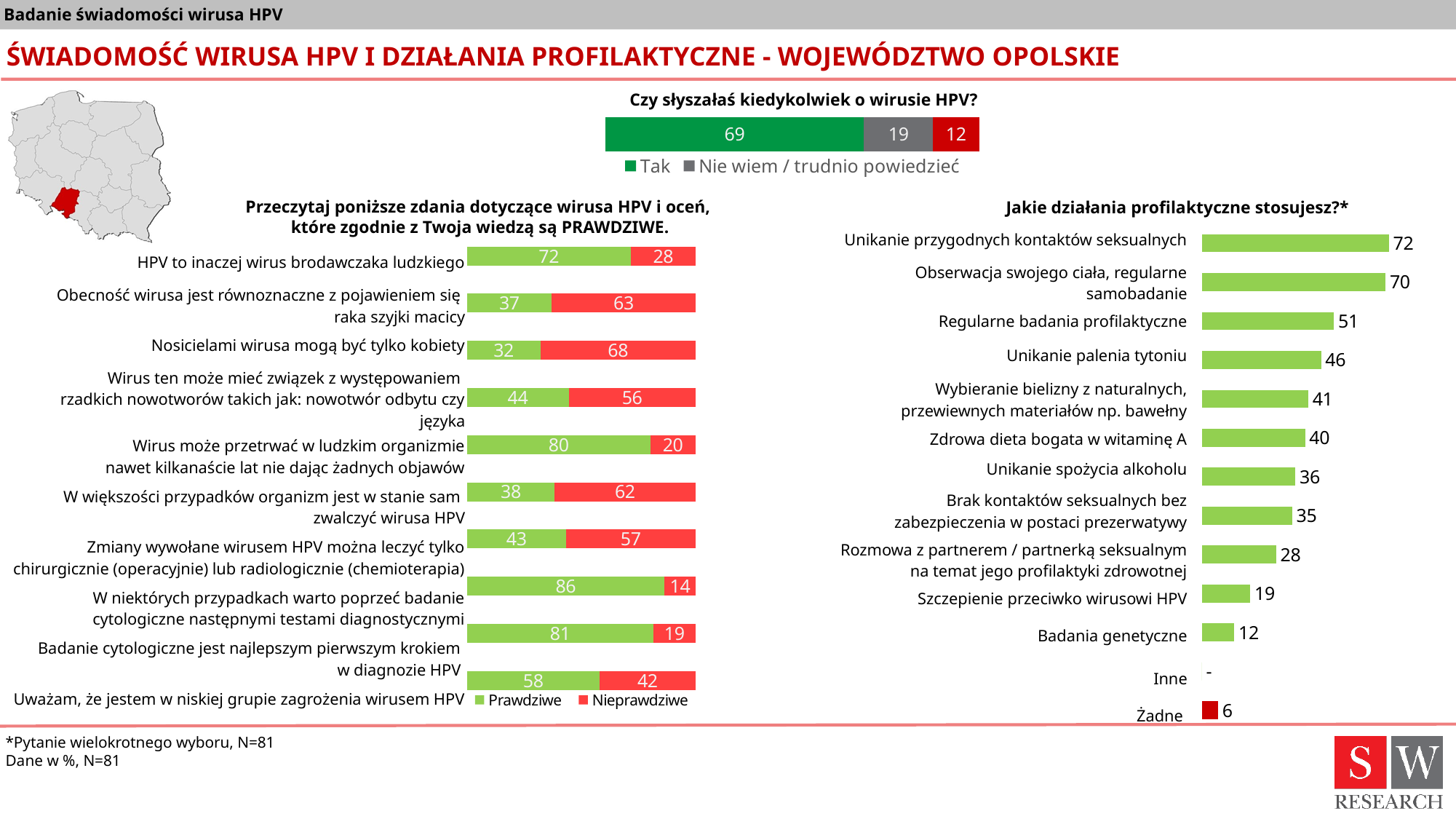
In the chart 'Czy słyszałaś kiedykolwiek o wirusie HPV?', what is the value of the red segment? 12 In the chart 'Przeczytaj poniższe zdania dotyczące wirusa HPV...', what is the 'Prawdziwe' value for 'HPV to inaczej wirus brodawczaka ludzkiego'? 72 In the chart 'Jakie działania profilaktyczne stosujesz?', what is the value for 'Unikanie palenia tytoniu'? 46 In the chart 'Czy słyszałaś kiedykolwiek o wirusie HPV?', what is the value for 'Tak'? 69 In the chart 'Jakie działania profilaktyczne stosujesz?', what is the difference between 'Regularne badania profilaktyczne' and 'Szczepienie przeciwko wirusowi HPV'? 32 What type of chart is 'Jakie działania profilaktyczne stosujesz?'? Bar chart In the chart 'Jakie działania profilaktyczne stosujesz?', what is the value for 'Badania genetyczne'? 12 In the chart 'Jakie działania profilaktyczne stosujesz?', which category has the highest value? Unikanie przygodnych kontaktów seksualnych In the chart 'Jakie działania profilaktyczne stosujesz?', which is larger: 'Zdrowa dieta bogata w witaminę A' or 'Unikanie spożycia alkoholu'? Zdrowa dieta bogata w witaminę A In the chart 'Jakie działania profilaktyczne stosujesz?', how many categories are listed? 13 In the chart 'Przeczytaj poniższe zdania dotyczące wirusa HPV...', what is the 'Nieprawdziwe' value for 'Uważam, że jestem w niskiej grupie zagrożenia wirusem HPV'? 42 In the chart 'Czy słyszałaś kiedykolwiek o wirusie HPV?', what is the value for 'Nie wiem / trudnio powiedzieć'? 19